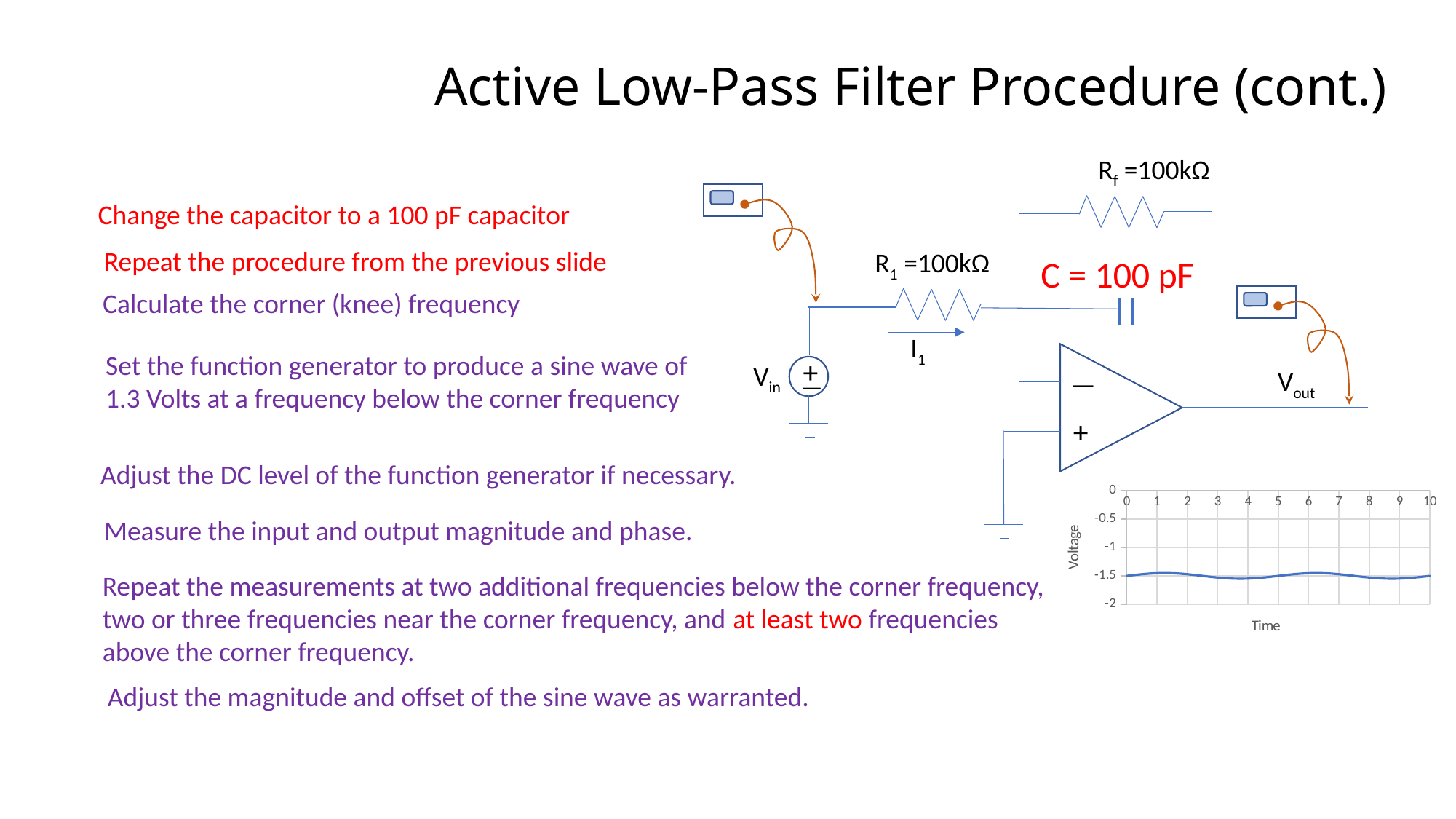
In the chart at the bottom right, what is the label of the vertical axis? Voltage In the chart at the bottom right, what is the lowest value shown on the vertical axis? -2 In the chart at the bottom right, is the plotted voltage at time 5 greater or less than -1? less In the chart at the bottom right, how many tick labels are shown on the horizontal axis from 0 to 10? 11 In the chart at the bottom right, what is the label of the horizontal axis? Time In the chart at the bottom right, is the plotted voltage at time 8 greater or less than -0.5? less In the chart at the bottom right, is the plotted voltage at time 2 greater or less than -2? greater What kind of chart is shown at the bottom right of the slide? line chart